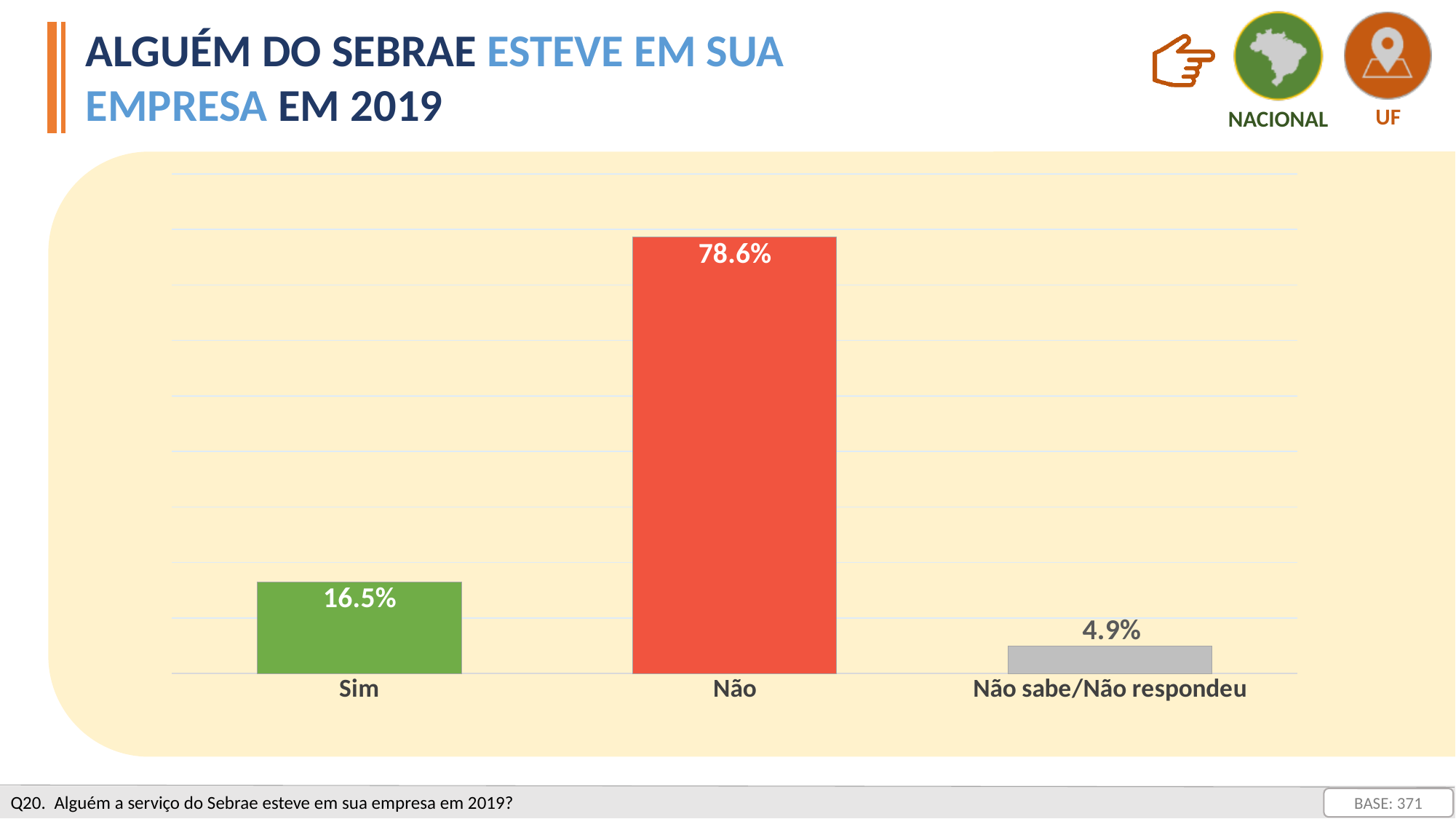
What is the base (number of respondents) shown on the slide? 371 What is the difference between the values for "Não" and "Sim"? 62.1% What colour is the bar for "Não"? Red What is the difference between the values for "Sim" and "Não sabe/Não respondeu"? 11.6% How many categories are shown in the chart? 3 What is the value for "Sim"? 16.5% What is the value for "Não sabe/Não respondeu"? 4.9% What is the value for "Não"? 78.6% What kind of chart is shown on the slide? Bar chart Which category has the lowest value? Não sabe/Não respondeu Which category has the highest value? Não Which is larger, the value for "Sim" or the value for "Não sabe/Não respondeu"? Sim